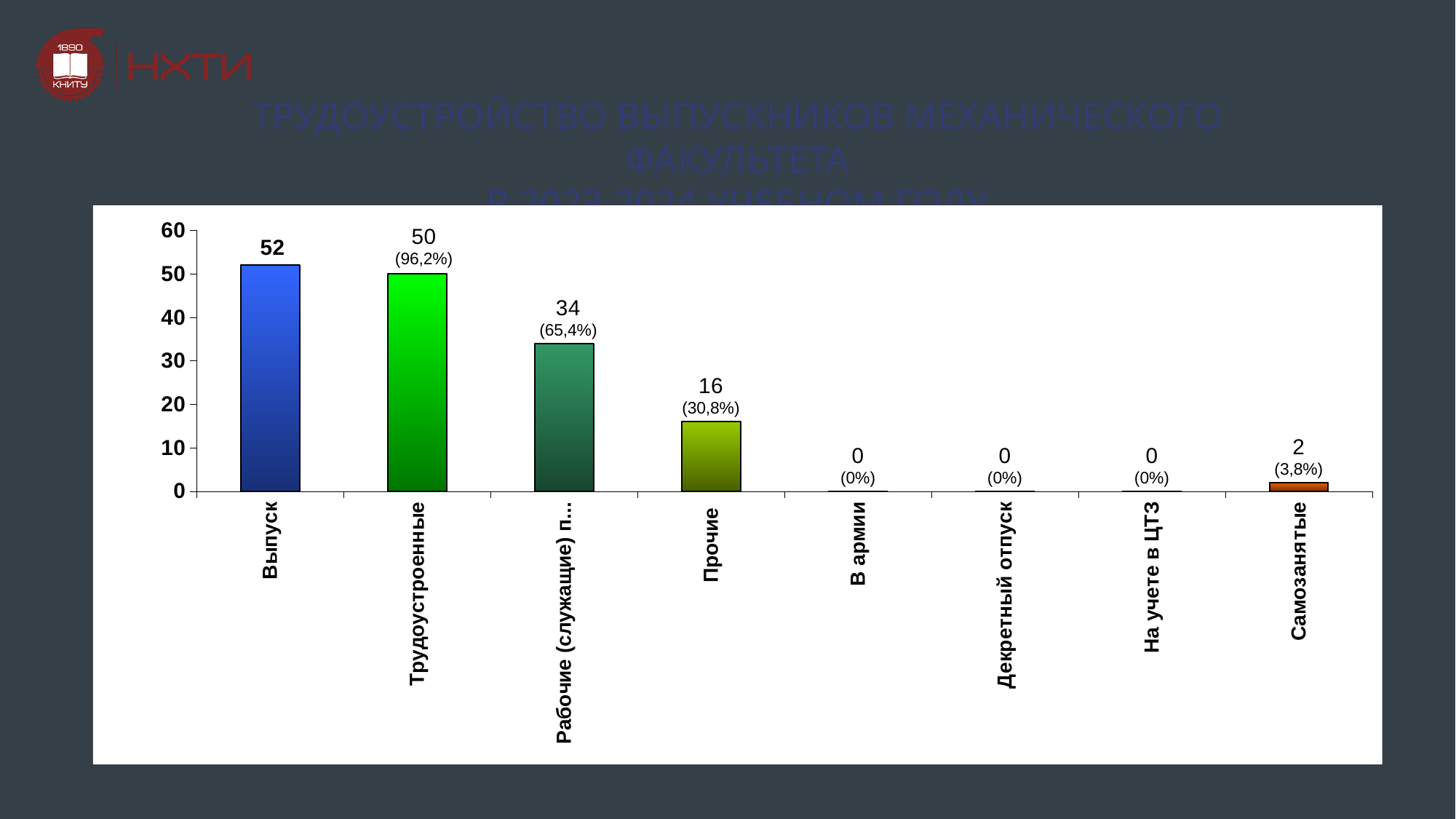
What is the value shown for Прочие? 16 What is the difference between the values for Выпуск and Трудоустроенные? 2 What is the value shown for Трудоустроенные? 50 How many categories are shown on the x axis? 8 Which is larger, the value for Прочие or the value for Самозанятые? Прочие What is the difference between the values for Трудоустроенные and Прочие? 34 Which category has the highest value? Выпуск What percentage is printed under the bar for Трудоустроенные? 96,2% What kind of chart is shown on the slide? bar chart What is the value shown for Выпуск? 52 What is the value shown for Самозанятые? 2 What is the value shown for В армии? 0